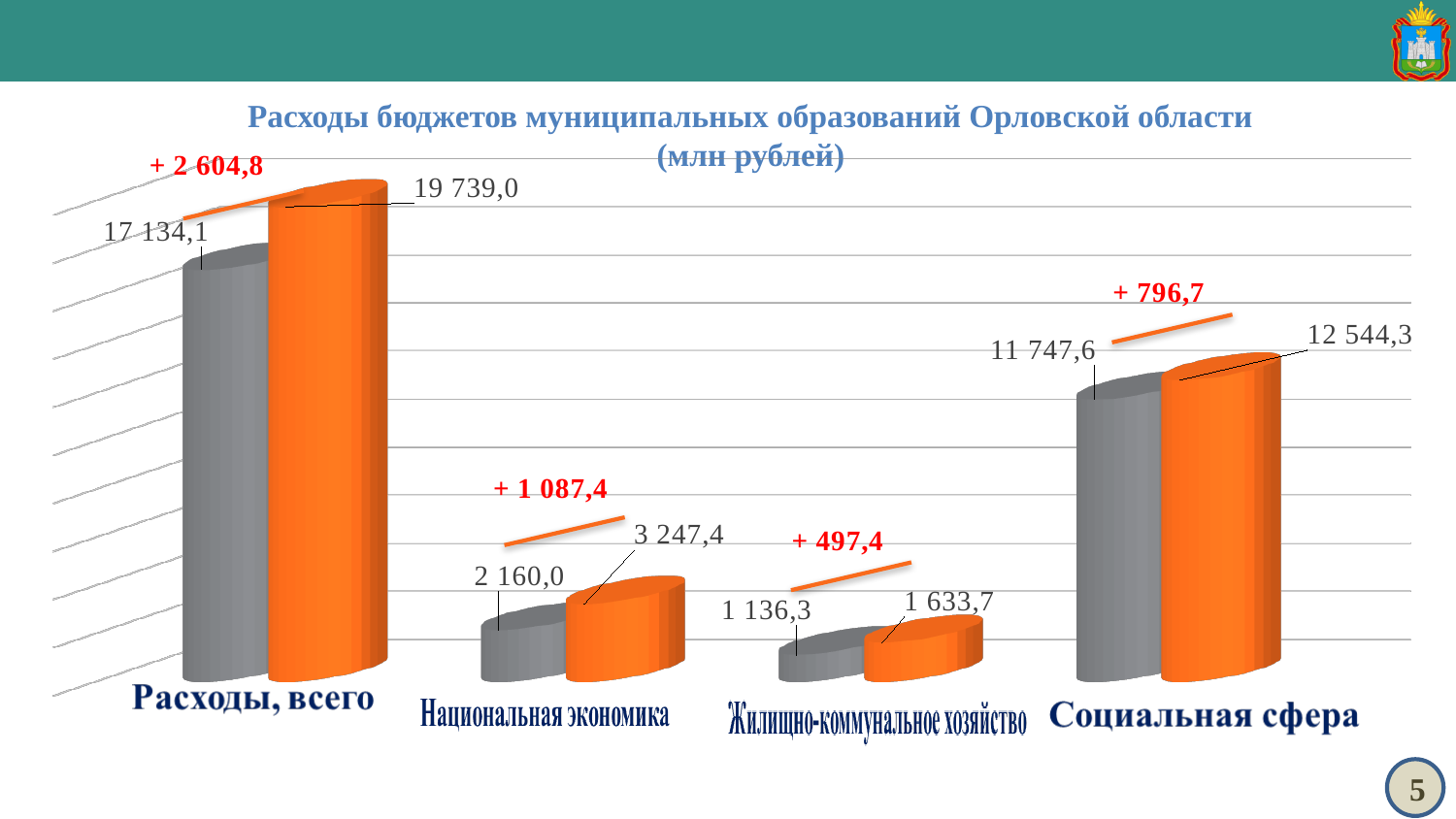
What is the value shown on the grey bar for Расходы, всего? 17 134,1 What type of chart is shown on the slide? bar chart Which category has the highest orange bar value? Расходы, всего Which is larger for Жилищно-коммунальное хозяйство: the grey bar or the orange bar? the orange bar What is the difference between the orange and grey bar values for Национальная экономика? 1 087,4 How many categories are shown on the x axis of the chart? 4 What is the value shown on the orange bar for Национальная экономика? 3 247,4 What is the value shown on the orange bar for Расходы, всего? 19 739,0 Which category has the lowest grey bar value? Жилищно-коммунальное хозяйство What is the value shown on the grey bar for Жилищно-коммунальное хозяйство? 1 136,3 What is the difference between the orange and grey bar values for Социальная сфера? 796,7 What is the value shown on the orange bar for Социальная сфера? 12 544,3